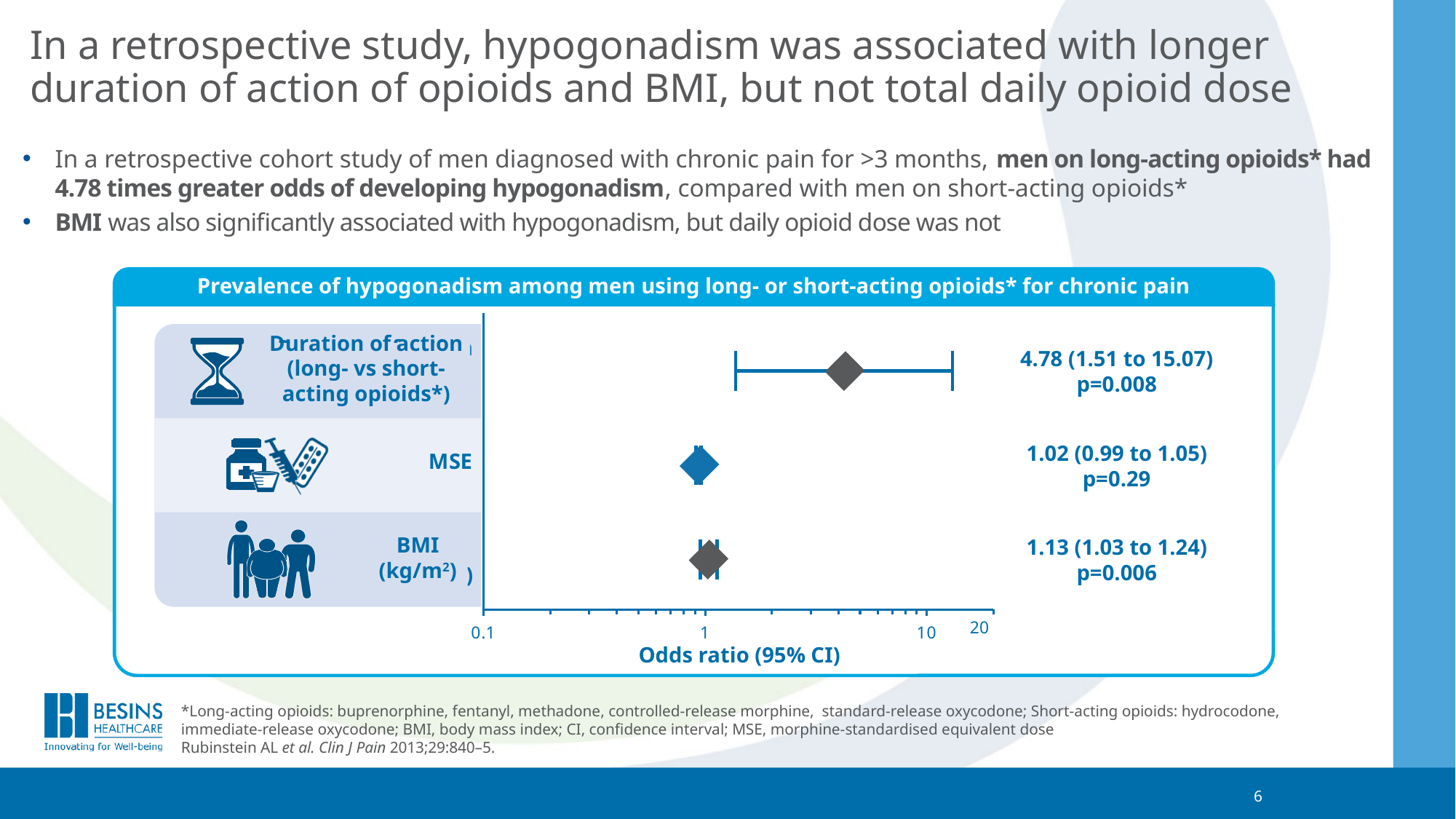
What is the odds ratio for Duration of action (long- vs short-acting opioids*)? 4.78 What is the p-value shown for MSE? p=0.29 Which category has the highest odds ratio? Duration of action (long- vs short-acting opioids*) Which has a larger odds ratio, BMI (kg/m²) or MSE? BMI (kg/m²) What is the label of the x axis of the chart? Odds ratio (95% CI) Is the odds ratio for Duration of action (long- vs short-acting opioids*) greater or less than 1? greater What is the p-value shown for Duration of action (long- vs short-acting opioids*)? p=0.008 What is the odds ratio for MSE? 1.02 What is the difference between the odds ratio for Duration of action and the odds ratio for BMI? 3.65 Which category has the lowest odds ratio? MSE What is the 95% confidence interval for BMI (kg/m²)? 1.03 to 1.24 How many categories are plotted in the chart? 3